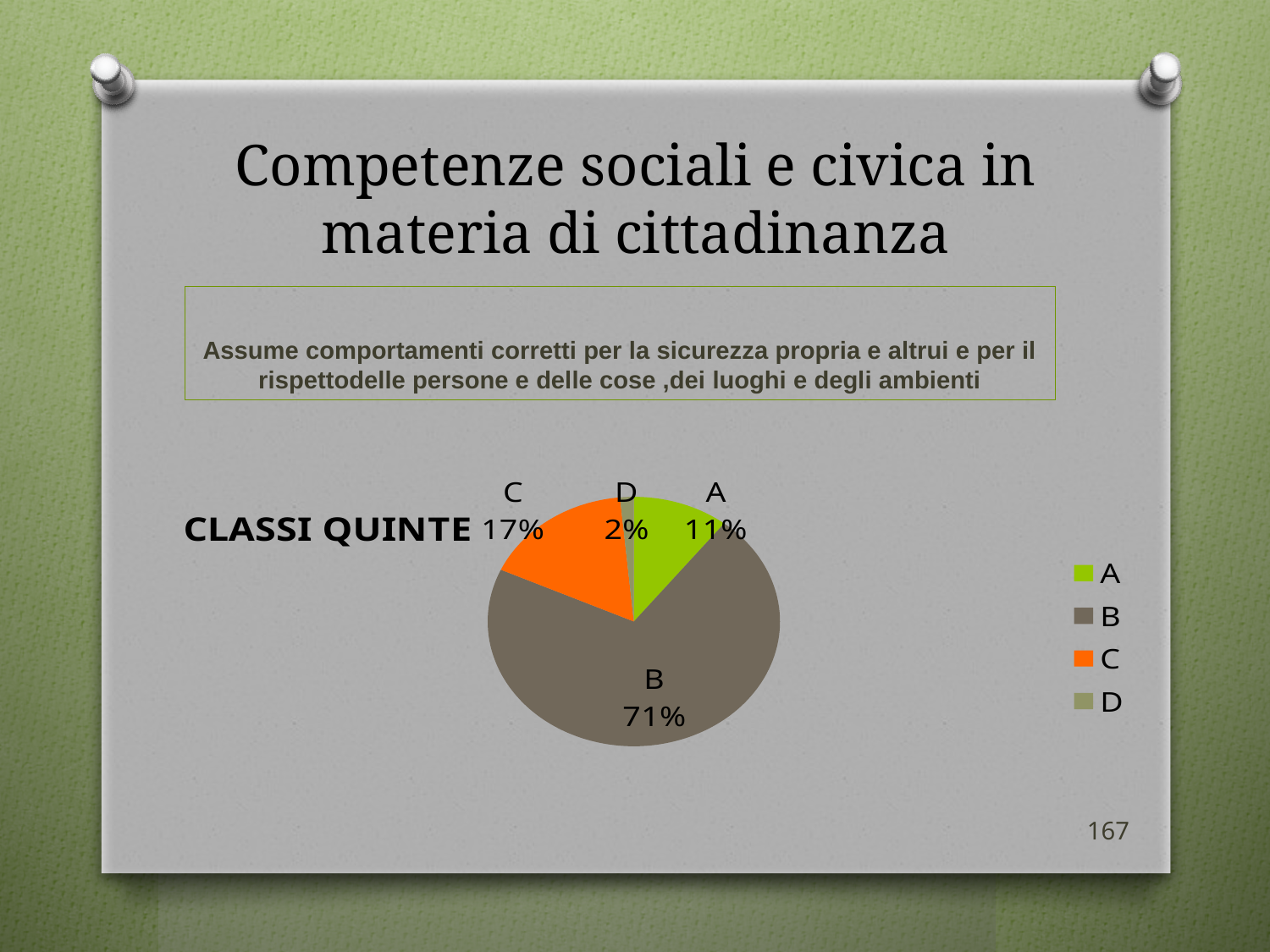
What percentage does slice A represent? 11% What kind of chart is shown on the slide? pie chart How many slices does the pie chart have? 4 What is the difference in percentage points between slice B and slice C? 54 Which slice is the largest? B Which is larger, slice A or slice C? C What colour is slice C in the chart? orange What percentage does slice D represent? 2% What percentage does slice B represent? 71% What is the title of the chart? CLASSI QUINTE Which slice is the smallest? D What percentage does slice C represent? 17%